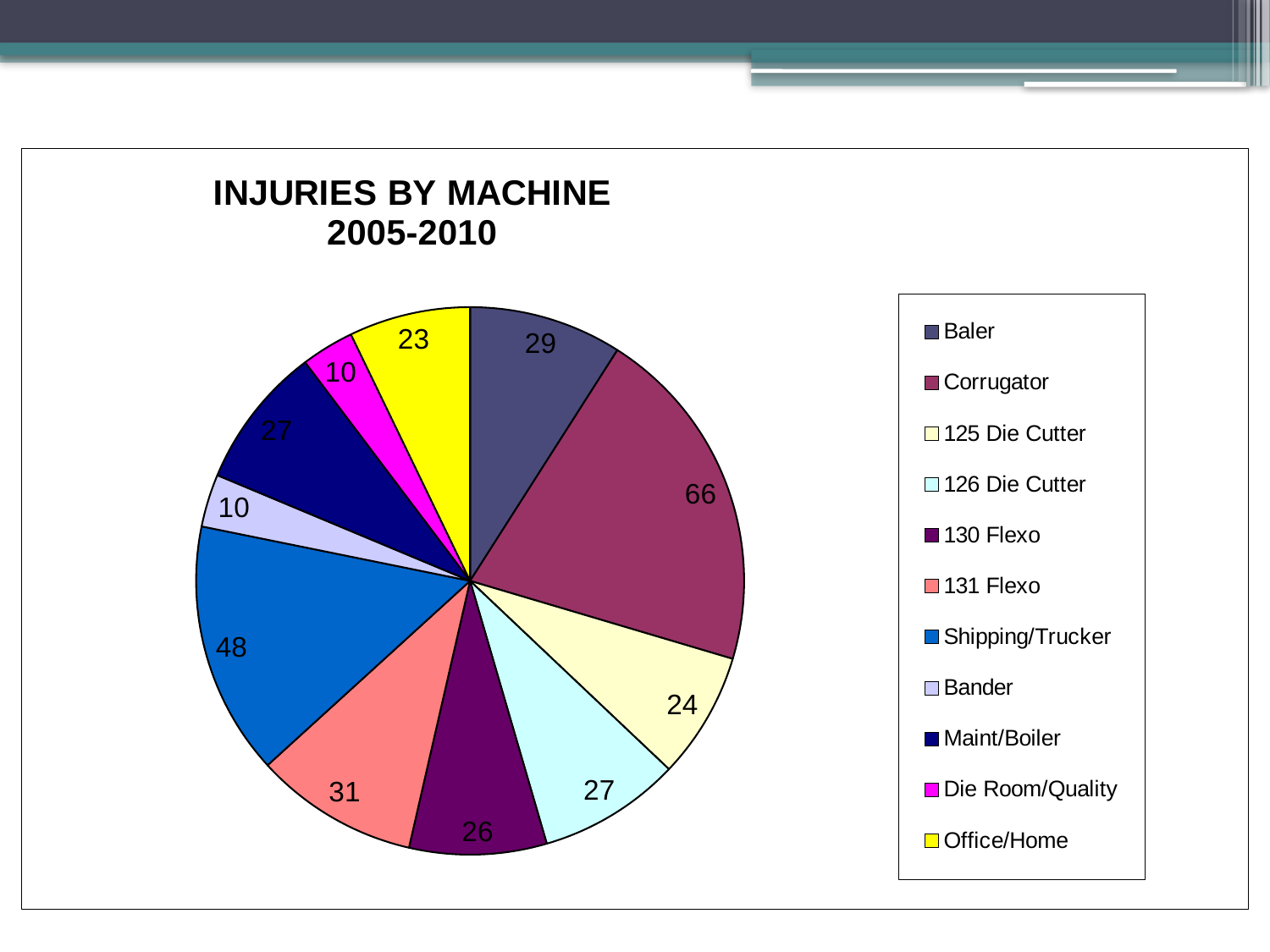
Which has more injuries, 131 Flexo or 130 Flexo? 131 Flexo How many injuries are shown for the Corrugator? 66 What is the difference in injuries between the Corrugator and Shipping/Trucker? 18 How many injuries are shown for the Baler? 29 Which two categories share the lowest number of injuries? Bander and Die Room/Quality What type of chart is shown on the slide? Pie chart Which machine category has the highest number of injuries? Corrugator How many injuries are shown for Office/Home? 23 What is the difference in injuries between 126 Die Cutter and 125 Die Cutter? 3 How many injuries are shown for Shipping/Trucker? 48 How many categories does the legend list? 11 What is the title of the chart? INJURIES BY MACHINE 2005-2010